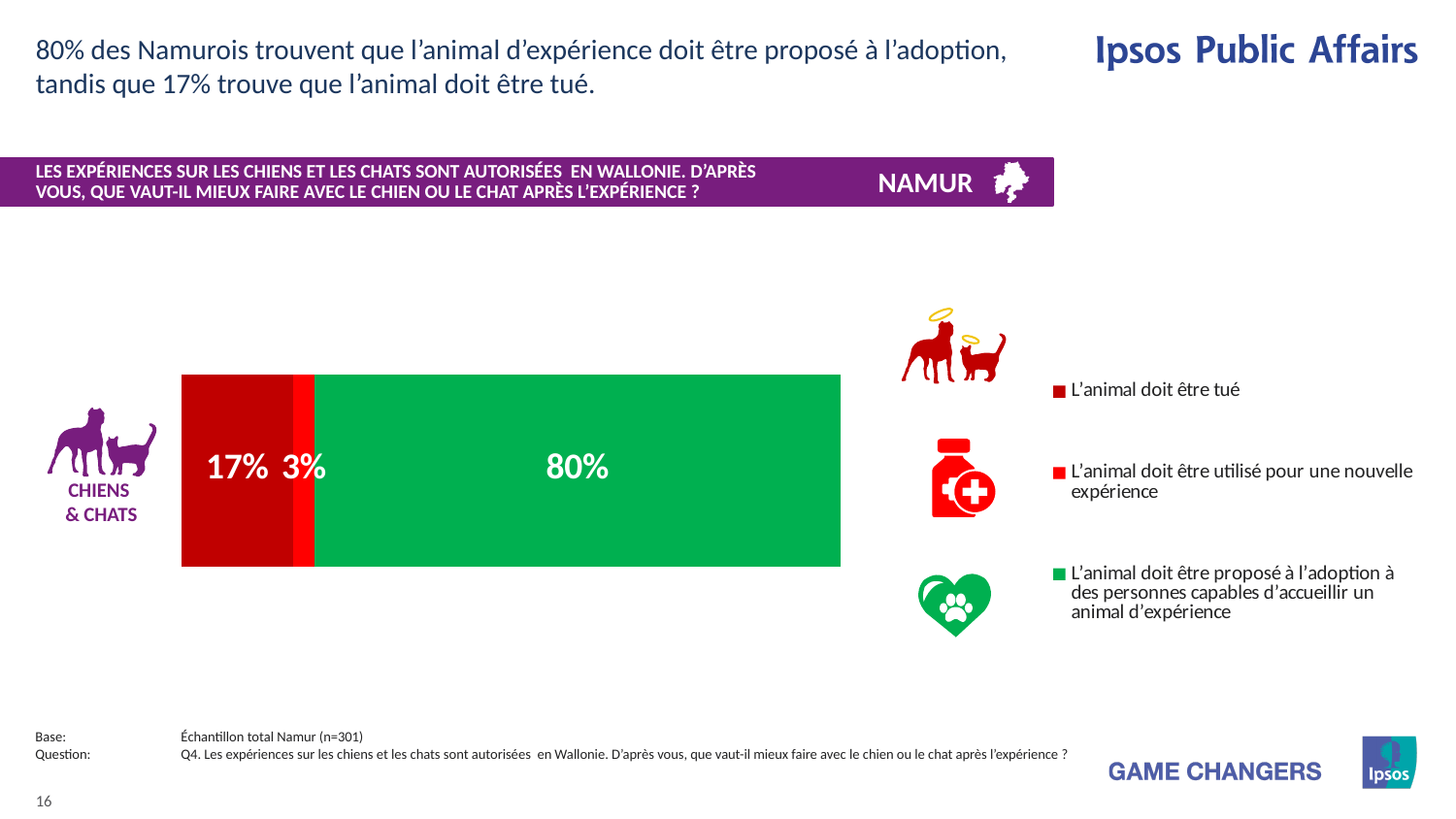
How many series does the legend list? 3 What is the label of the single category shown on the bar chart? CHIENS & CHATS What is the difference between the share for adoption (80%) and the share for the animal being killed (17%)? 63 percentage points Which is larger: the share for 'L'animal doit être tué' or the share for 'L'animal doit être utilisé pour une nouvelle expérience'? L'animal doit être tué What colour is the segment for 'L'animal doit être proposé à l'adoption'? Green Which response option has the smallest share in the bar? L'animal doit être utilisé pour une nouvelle expérience What percentage of respondents say the animal should be offered for adoption (L'animal doit être proposé à l'adoption)? 80% Which response option has the largest share in the bar? L'animal doit être proposé à l'adoption à des personnes capables d'accueillir un animal d'expérience What is the total of the three segments in the stacked bar? 100% What kind of chart is shown on the slide? Stacked bar chart What percentage of respondents say the animal should be used for a new experiment (L'animal doit être utilisé pour une nouvelle expérience)? 3% What percentage of respondents say the animal should be killed (L'animal doit être tué)? 17%